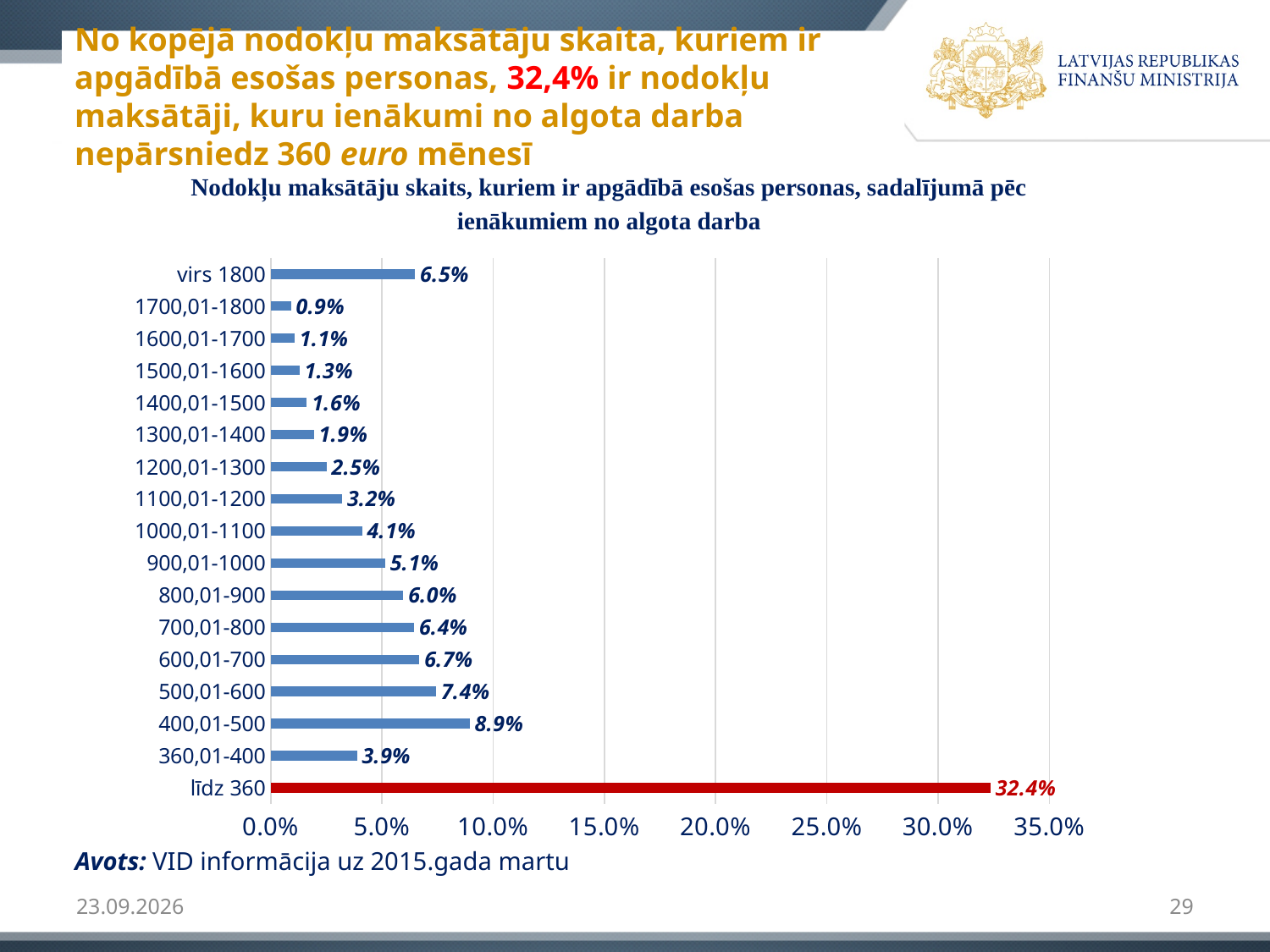
Which category has the lowest value? 1700,01-1800 Which is larger, the value for "600,01-700" or the value for "800,01-900"? 600,01-700 What is the value for the "virs 1800" category? 6.5% How many categories are shown in the chart? 17 What is the value for the "līdz 360" category? 32.4% What is the difference between the values for "500,01-600" and "360,01-400"? 3.5% What is the difference between the values for "līdz 360" and "400,01-500"? 23.5% What kind of chart is shown on the slide? bar chart Which bar in the chart is coloured red rather than blue? līdz 360 What is the value for the "400,01-500" category? 8.9% What is the value for the "1000,01-1100" category? 4.1% Which category has the highest value? līdz 360